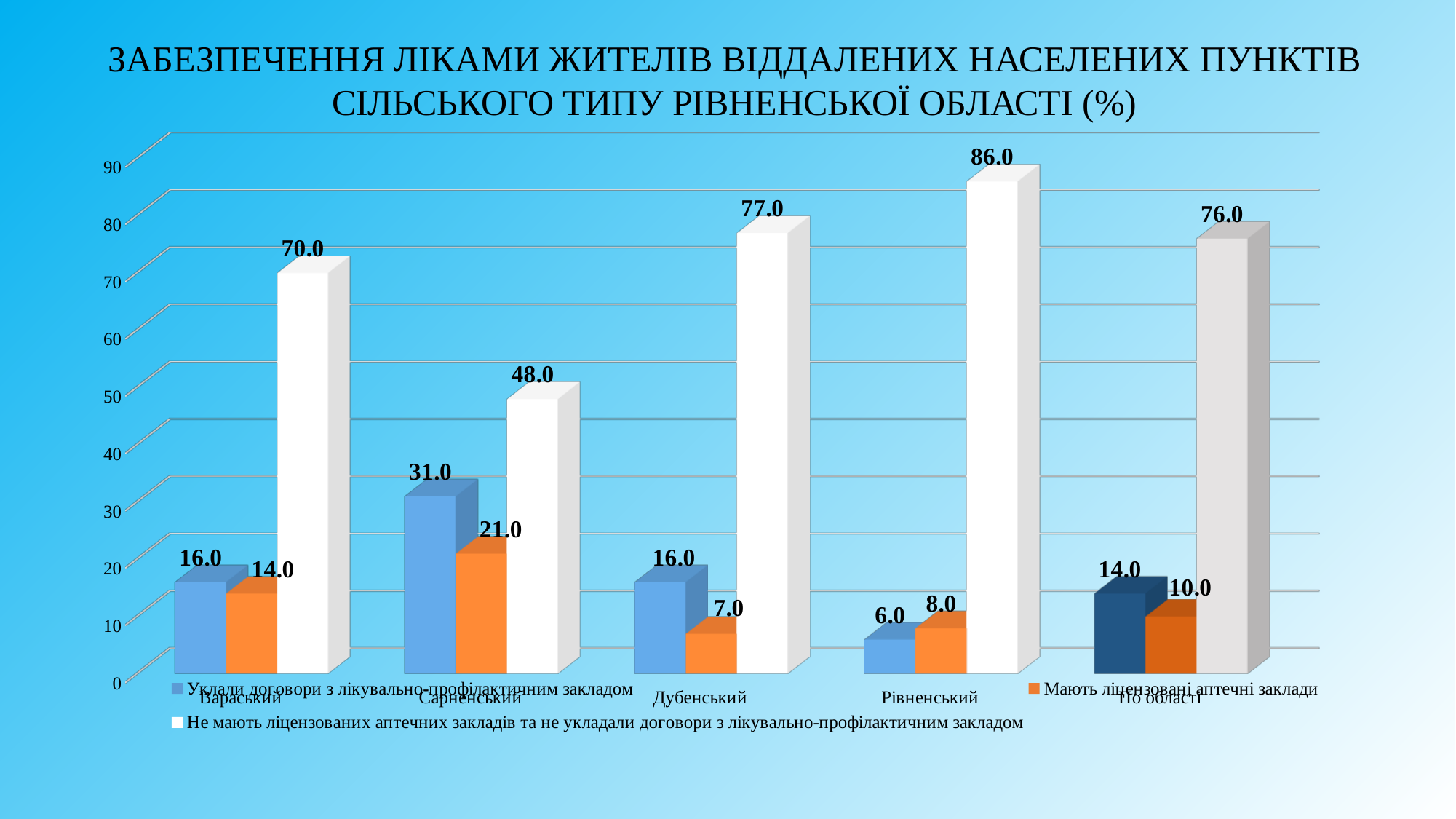
What is the difference between the values for Дубенський and Вараський in the series "Не мають ліцензованих аптечних закладів та не укладали договори з лікувально-профілактичним закладом"? 7.0 How many series does the legend list? 3 What is the value for Дубенський in the series "Мають ліцензовані аптечні заклади"? 7.0 What type of chart is shown on the slide? bar chart How many categories are shown on the x axis? 5 What is the value for Сарненський in the series "Уклали договори з лікувально-профілактичним закладом"? 31.0 Which category has the highest value in the series "Мають ліцензовані аптечні заклади"? Сарненський Which category has the lowest value in the series "Уклали договори з лікувально-профілактичним закладом"? Рівненський Which is larger for Рівненський: the value for "Уклали договори з лікувально-профілактичним закладом" or the value for "Мають ліцензовані аптечні заклади"? Мають ліцензовані аптечні заклади Which category has the highest value in the series "Не мають ліцензованих аптечних закладів та не укладали договори з лікувально-профілактичним закладом"? Рівненський What is the value for По області in the series "Мають ліцензовані аптечні заклади"? 10.0 What is the value for Рівненський in the series "Не мають ліцензованих аптечних закладів та не укладали договори з лікувально-профілактичним закладом"? 86.0